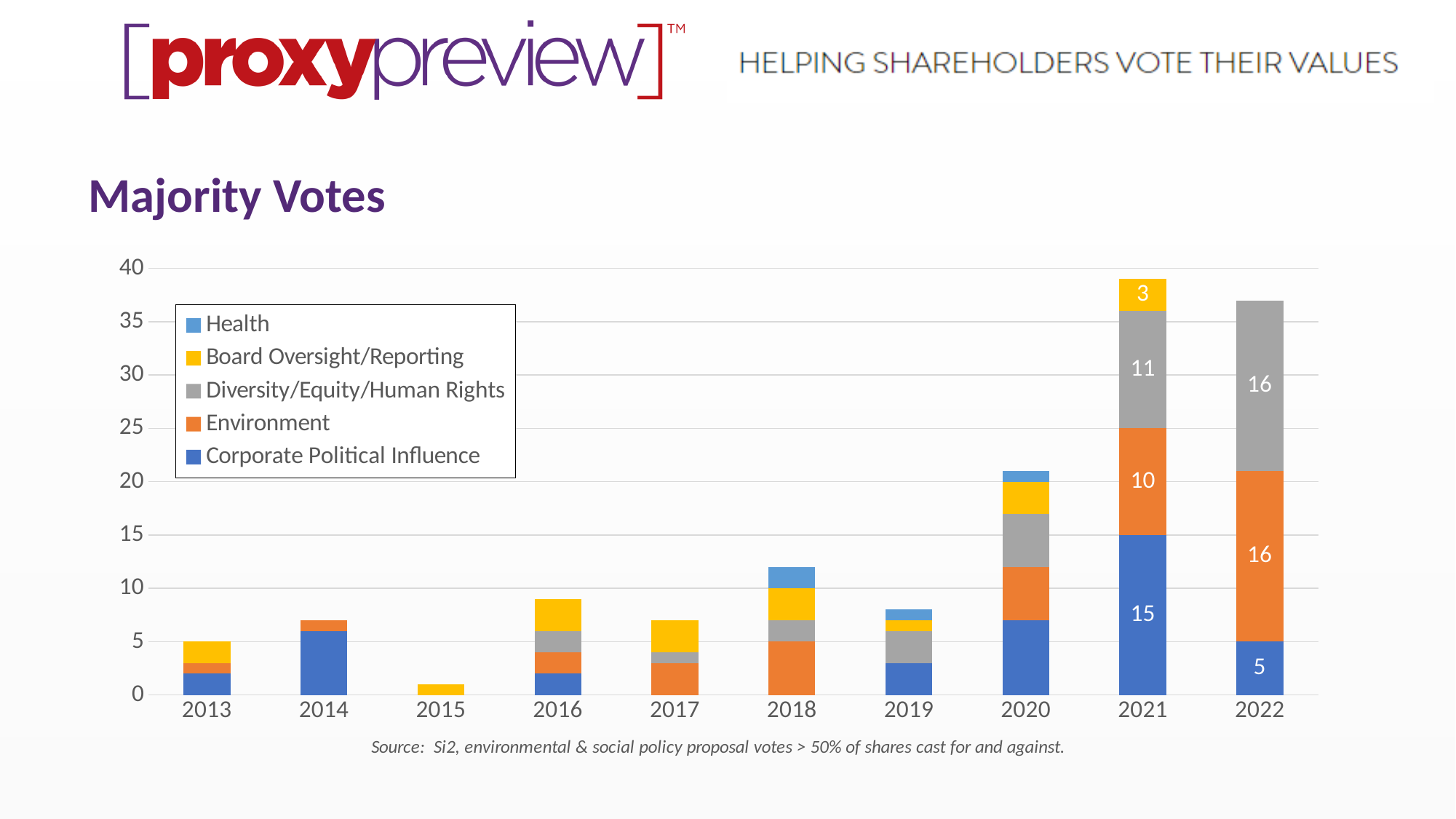
What is the value for Diversity/Equity/Human Rights in 2021? 11 How many series does the legend list? 5 Which year has the larger Environment value, 2021 or 2022? 2022 What is the difference between the Corporate Political Influence values for 2021 and 2022? 10 What is the value for Board Oversight/Reporting in 2021? 3 How many years are shown along the x axis? 10 What is the total of the stacked bar for 2022? 37 Is the total value for 2015 greater or less than 5? less What is the value for Environment in 2022? 16 What is the value for Corporate Political Influence in 2021? 15 What kind of chart is shown on the slide? bar chart What is the total of the stacked bar for 2021? 39